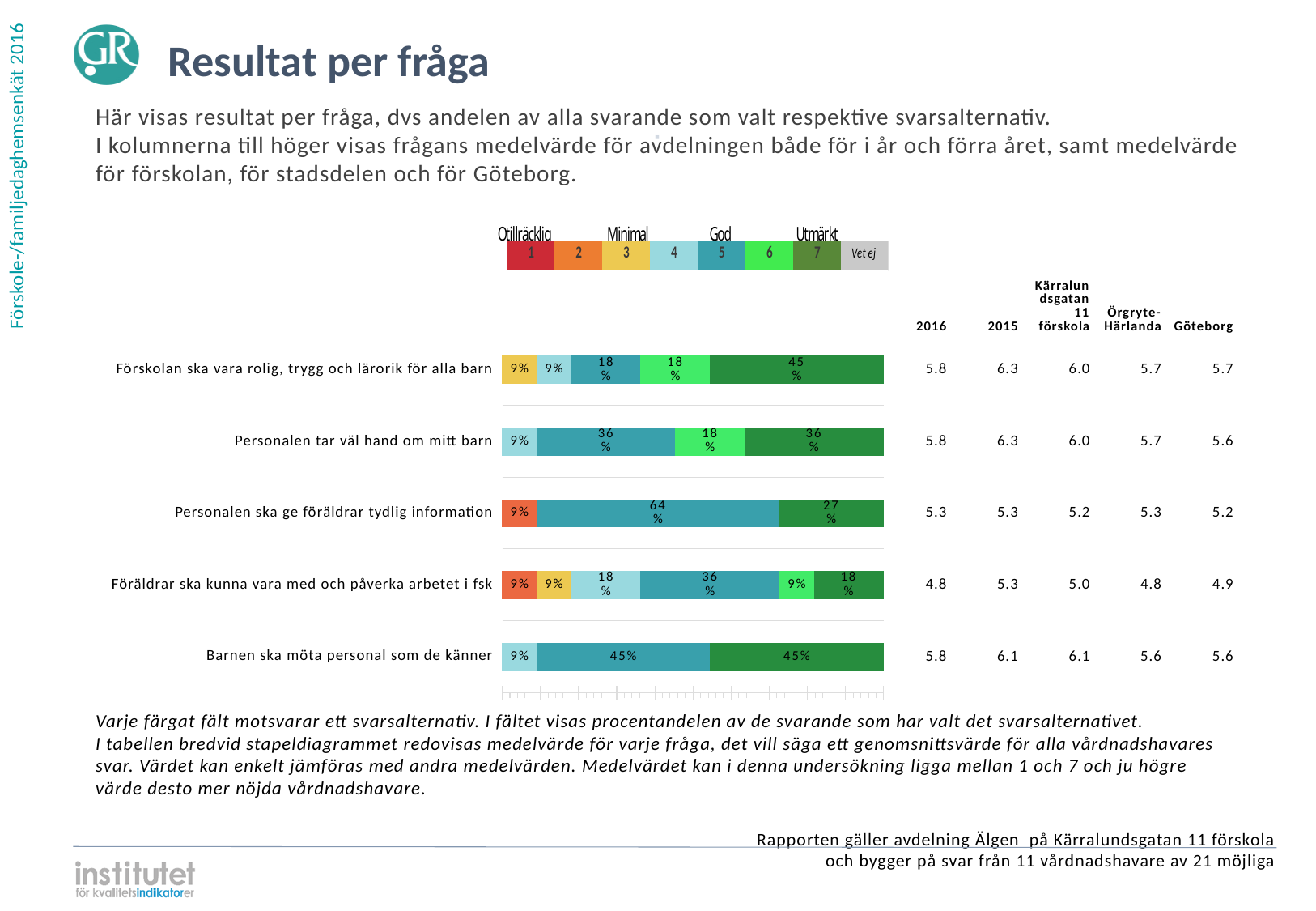
Which answer option has the largest share for 'Personalen ska ge föräldrar tydlig information'? 5 (64%) How many questions (categories) are plotted as bars in the chart? 5 For 'Barnen ska möta personal som de känner', which is larger: the share for answer 5 or the share for answer 4? Answer 5 (45%) Which question has the largest share of respondents choosing answer 7 (dark green)? Förskolan ska vara rolig, trygg och lärorik för alla barn and Barnen ska möta personal som de känner (both 45%) What kind of chart is shown on the slide? Stacked bar chart Which colour in the legend represents answer option 7 ('Utmärkt')? Dark green How many entries does the colour legend above the chart list (including 'Vet ej')? 8 What is the difference between the share for answer 7 and the share for answer 6 in 'Förskolan ska vara rolig, trygg och lärorik för alla barn'? 27 percentage points What percentage of respondents chose answer 5 (teal) for 'Personalen ska ge föräldrar tydlig information'? 64% What percentage of respondents chose answer 7 (dark green) for 'Förskolan ska vara rolig, trygg och lärorik för alla barn'? 45% What percentage of respondents chose answer 6 (light green) for 'Föräldrar ska kunna vara med och påverka arbetet i fsk'? 9% What percentage of respondents chose answer 7 (dark green) for 'Personalen tar väl hand om mitt barn'? 36%